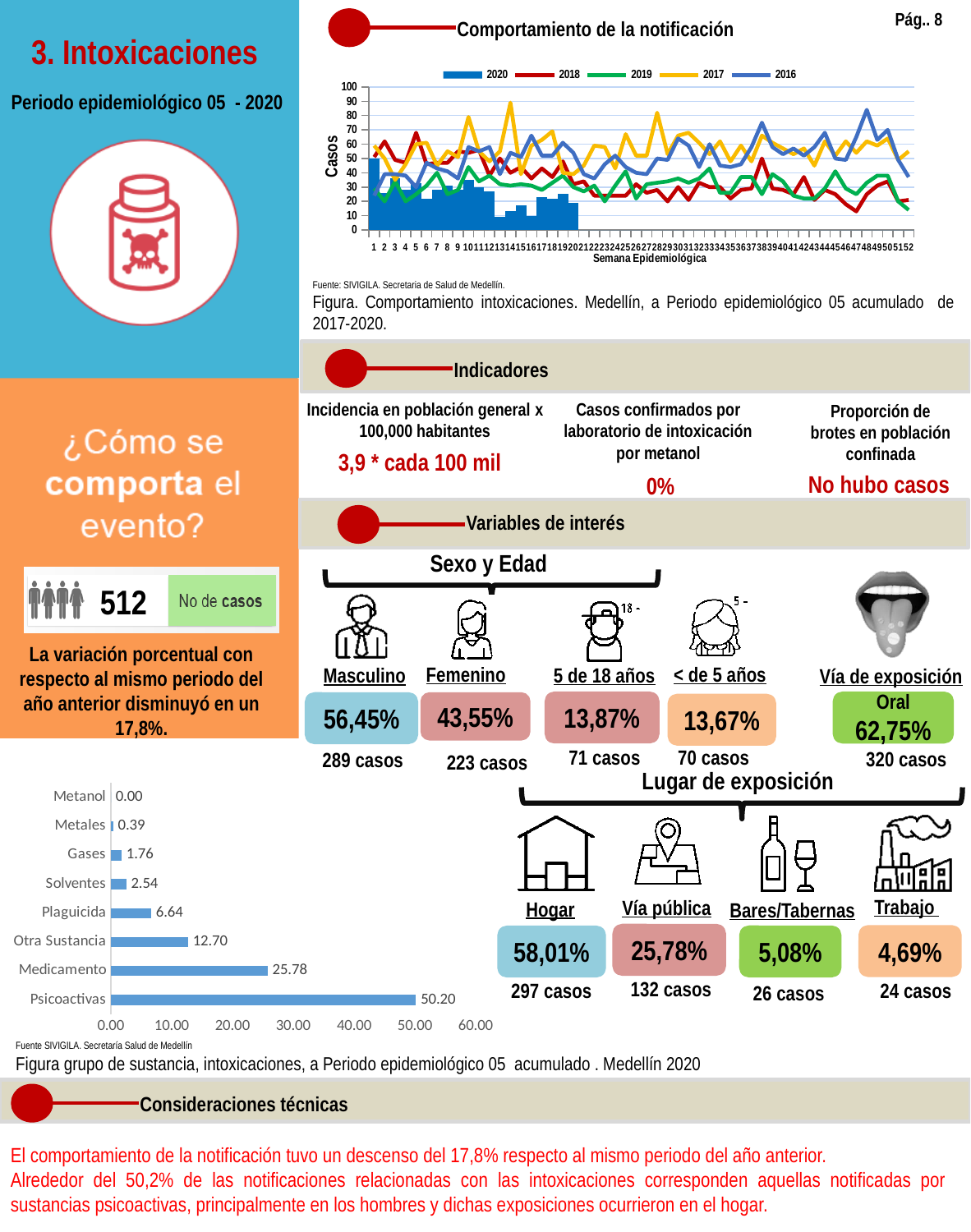
In the bottom-left bar chart of substance groups, what is the value for Plaguicida? 6.64 What is the x-axis label of the top chart 'Comportamiento de la notificación'? Semana Epidemiológica In the bottom-left bar chart of substance groups, which category has the highest value? Psicoactivas How many series does the legend of the top chart 'Comportamiento de la notificación' list? 5 In the bottom-left bar chart of substance groups, what is the difference between the values for Psicoactivas and Medicamento? 24.42 In the bottom-left bar chart of substance groups, what is the value for Psicoactivas? 50.20 How many categories are shown in the bottom-left bar chart of substance groups? 8 In the bottom-left bar chart of substance groups, which is larger, the value for Solventes or the value for Gases? Solventes What kind of chart is the bottom-left chart of substance groups? Bar chart In the top chart 'Comportamiento de la notificación', is the value for 2017 at week 14 greater or less than 70? greater In the bottom-left bar chart of substance groups, which category has the lowest value? Metanol In the bottom-left bar chart of substance groups, what is the value for Medicamento? 25.78